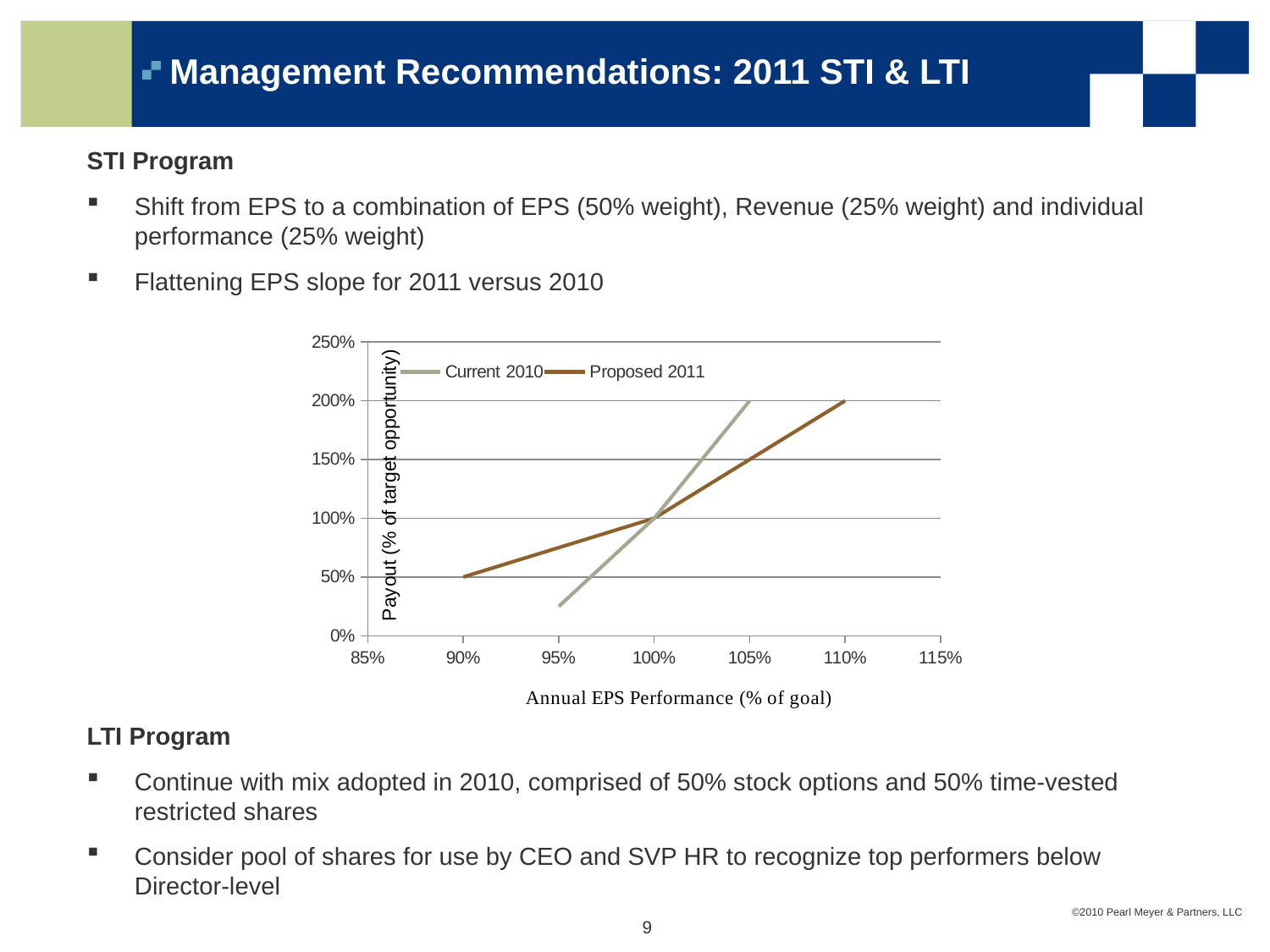
What kind of chart is shown on the slide? line chart What is the label of the chart's x axis? Annual EPS Performance (% of goal) Is the payout for the Current 2010 line at 95% EPS performance greater or less than 50%? less What is the payout for both lines at 100% annual EPS performance? 100% What payout does the Current 2010 line reach at 105% annual EPS performance? 200% How many series does the chart legend list? 2 Do the payout values rise or fall as annual EPS performance increases along the x axis? rise What payout does the Proposed 2011 line reach at 110% annual EPS performance? 200% What are the two series named in the chart legend? Current 2010 and Proposed 2011 At 105% annual EPS performance, which line shows the higher payout, Current 2010 or Proposed 2011? Current 2010 What is the payout for the Proposed 2011 line at 90% annual EPS performance? 50%